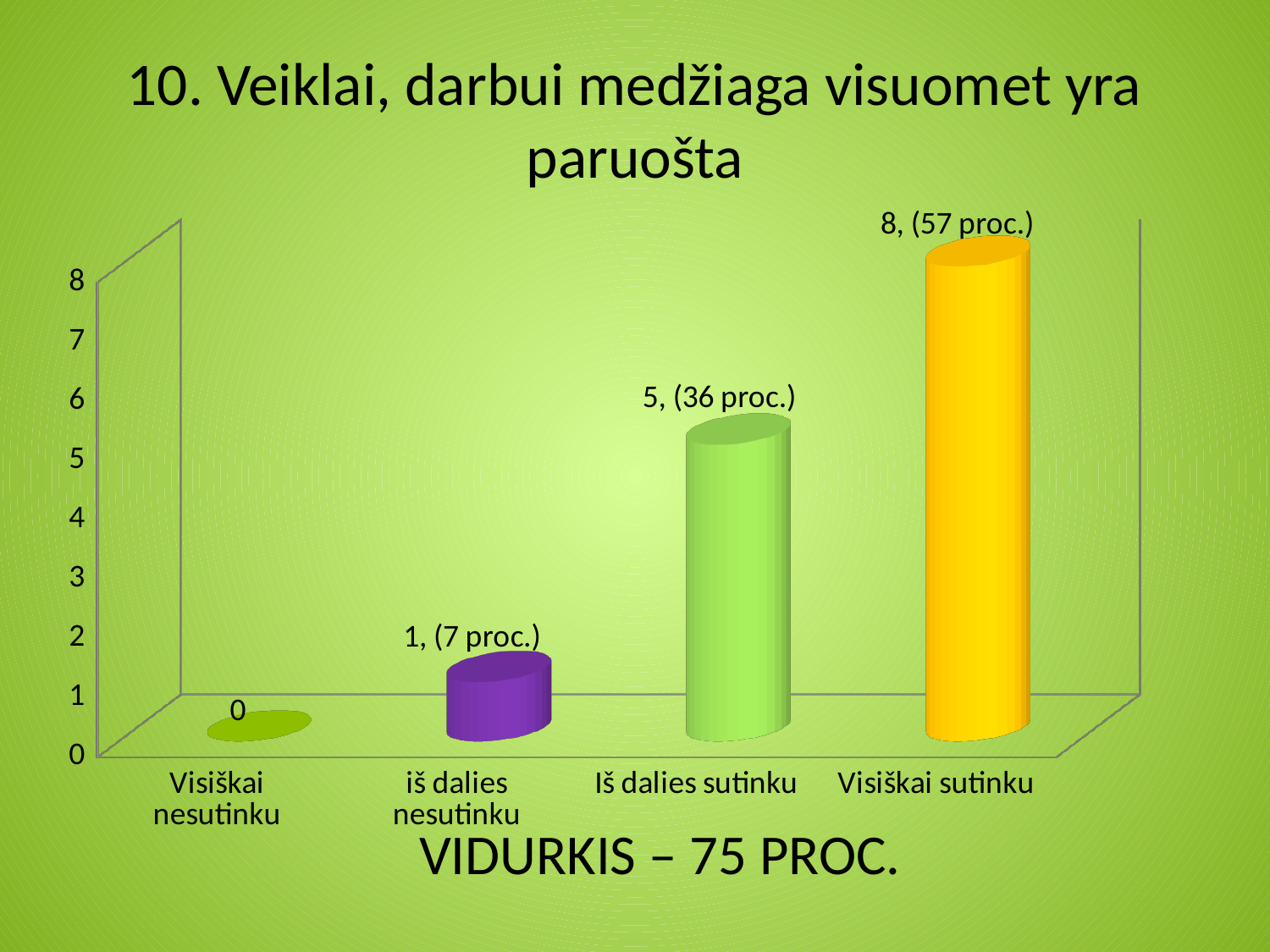
Which category has the highest value? Visiškai sutinku What is the value for "Visiškai sutinku"? 8, (57 proc.) How many categories are shown on the x axis? 4 What is the value for "iš dalies nesutinku"? 1, (7 proc.) Do the values rise or fall from left to right along the x axis? rise What is the title of the chart? 10. Veiklai, darbui medžiaga visuomet yra paruošta What kind of chart is shown on the slide? bar chart Which is larger, the value for "Iš dalies sutinku" or "iš dalies nesutinku"? Iš dalies sutinku What is the difference between the counts for "Visiškai sutinku" and "Iš dalies sutinku"? 3 What is the value for "Iš dalies sutinku"? 5, (36 proc.) Which category has the lowest value? Visiškai nesutinku What is the value for "Visiškai nesutinku"? 0